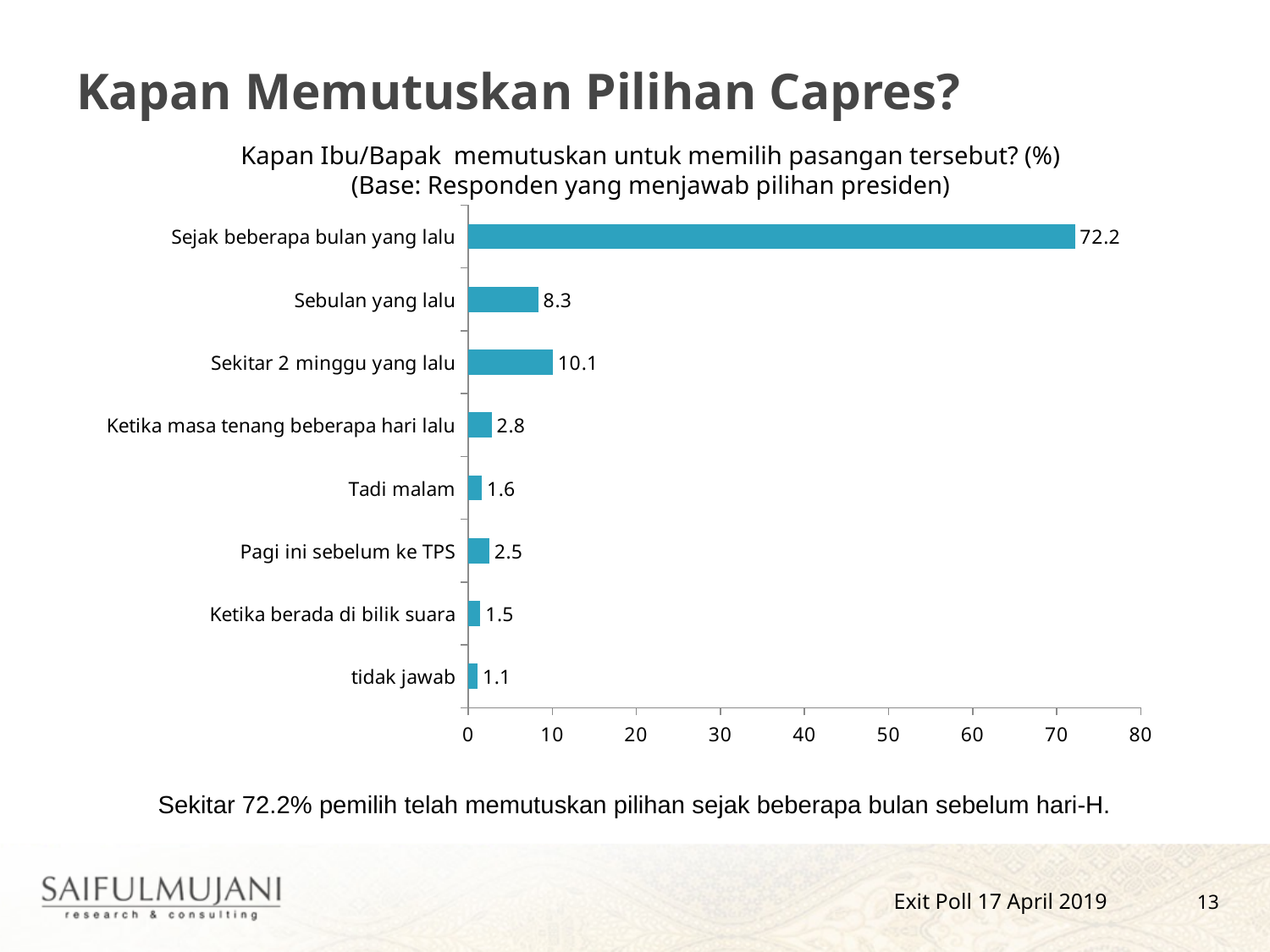
What kind of chart is shown on the slide? bar chart What is the difference between the values for "Tadi malam" and "Ketika berada di bilik suara"? 0.1 What is the value for "Sejak beberapa bulan yang lalu"? 72.2 Which category has the highest value? Sejak beberapa bulan yang lalu What is the difference between the values for "Sekitar 2 minggu yang lalu" and "Sebulan yang lalu"? 1.8 How many categories are shown in the chart? 8 What is the maximum value shown on the x axis? 80 What is the value for "Pagi ini sebelum ke TPS"? 2.5 What is the value for "Sekitar 2 minggu yang lalu"? 10.1 Which category has the lowest value? tidak jawab Which is larger, the value for "Ketika masa tenang beberapa hari lalu" or the value for "Pagi ini sebelum ke TPS"? Ketika masa tenang beberapa hari lalu Is the value for "Sejak beberapa bulan yang lalu" greater or less than 70? greater